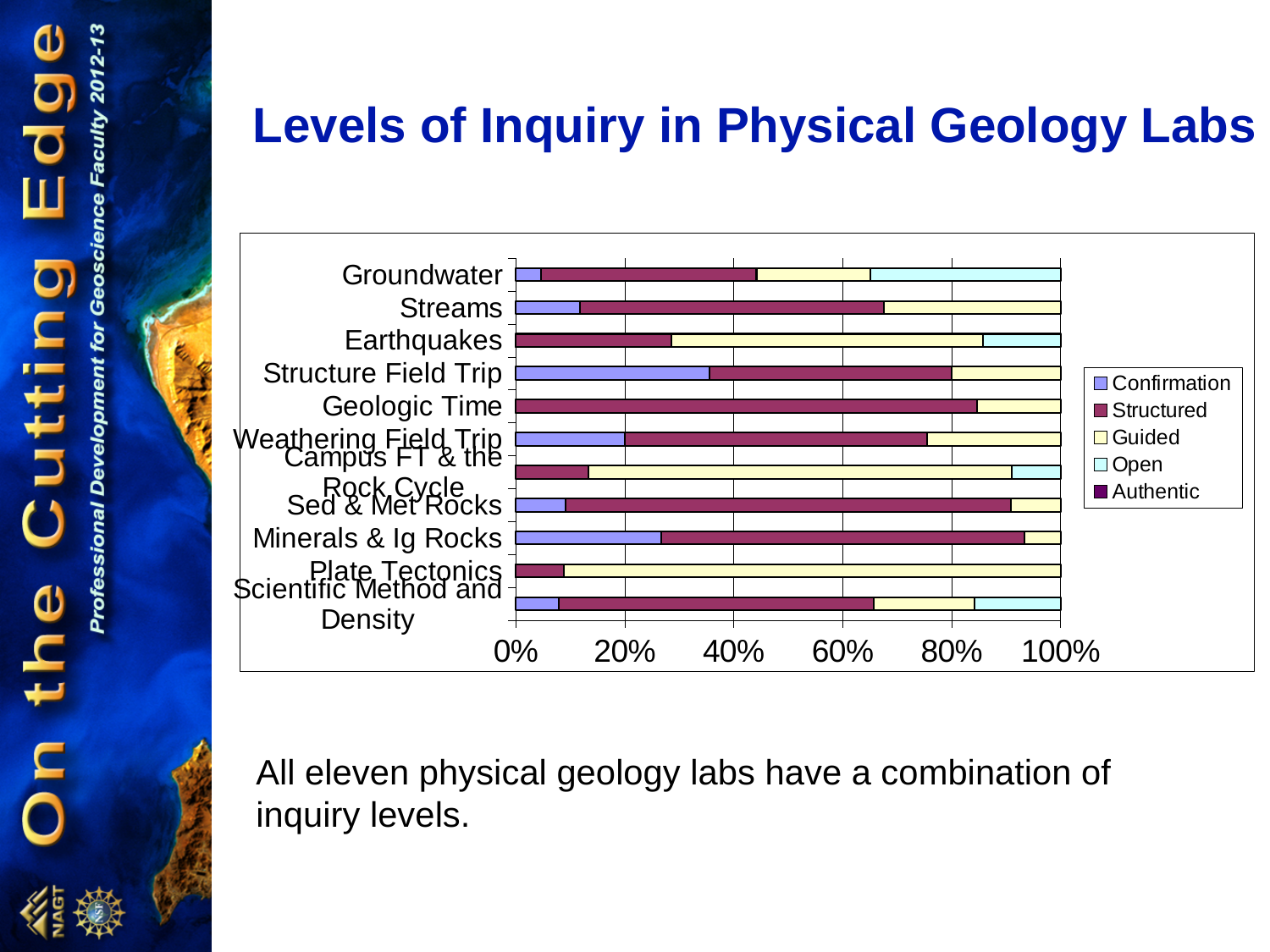
How many series does the legend list? 5 What is the title of the slide's chart? Levels of Inquiry in Physical Geology Labs Which lab has the larger Confirmation share, Structure Field Trip or Streams? Structure Field Trip Which lab has the largest Structured share? Geologic Time How many labs (categories) are plotted on the chart? 11 Which lab has the largest Open share? Groundwater Which lab has the largest Guided share? Plate Tectonics Is the Structured share for Geologic Time greater or less than 80%? greater What kind of chart is shown on the slide? Stacked bar chart Is the Structured share for Earthquakes greater or less than 40%? less